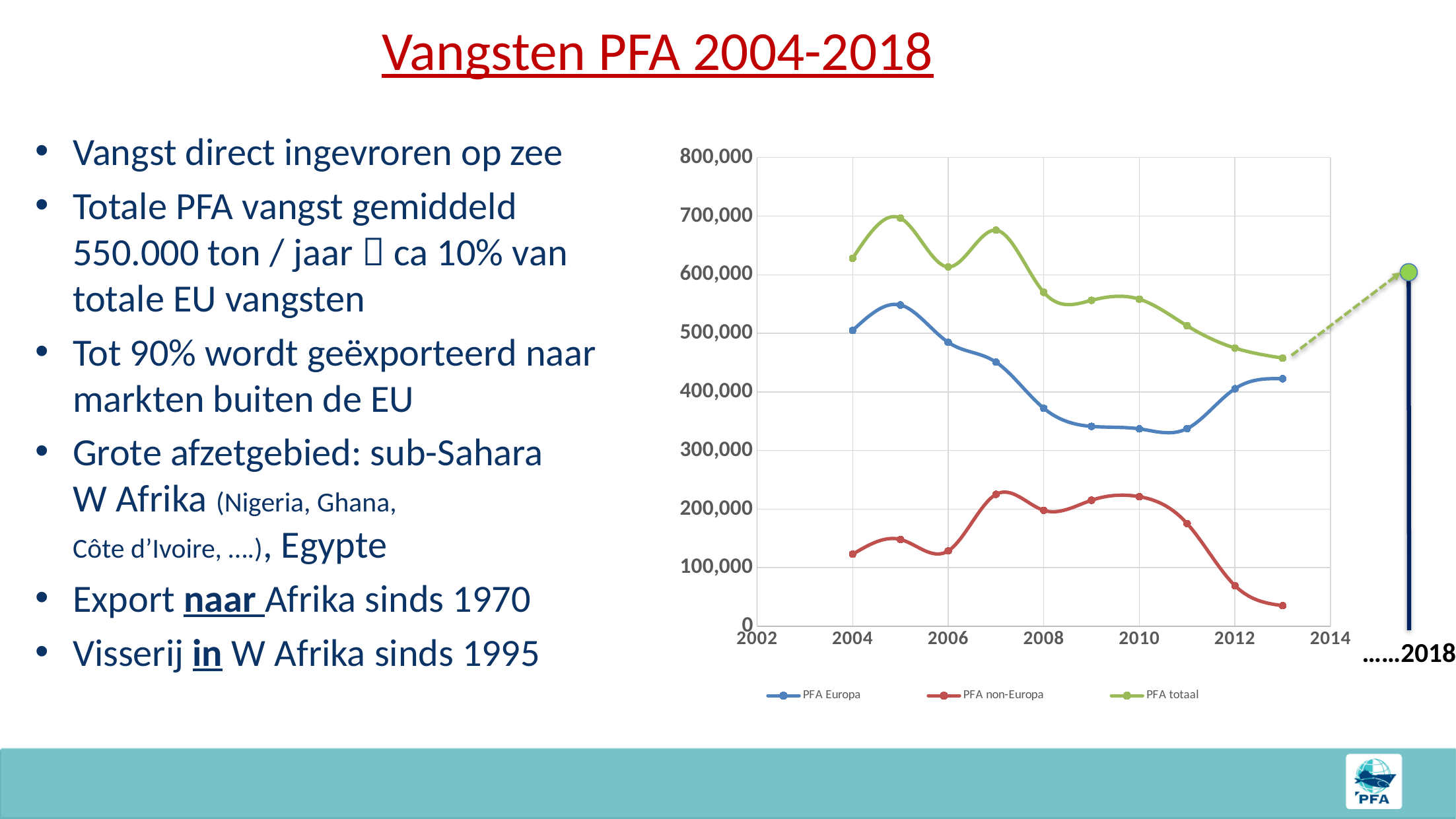
Is the value for PFA Europa in 2010 greater or less than 400,000? less Which series are listed in the chart legend? PFA Europa, PFA non-Europa, PFA totaal How many data points does the PFA totaal series have (excluding the dashed projection)? 10 How many series does the chart legend list? 3 Does the PFA Europa series rise or fall between 2011 and 2013? rise What kind of chart is shown on the slide? line chart Does the PFA non-Europa series rise or fall between 2011 and 2013? fall Is the value for PFA non-Europa in 2013 greater or less than 100,000? less Which series has the higher value in 2008, PFA Europa or PFA non-Europa? PFA Europa Is the value for PFA totaal in 2005 greater or less than 600,000? greater In which year does the PFA non-Europa series reach its lowest value? 2013 In which year does the PFA totaal series reach its highest value? 2005